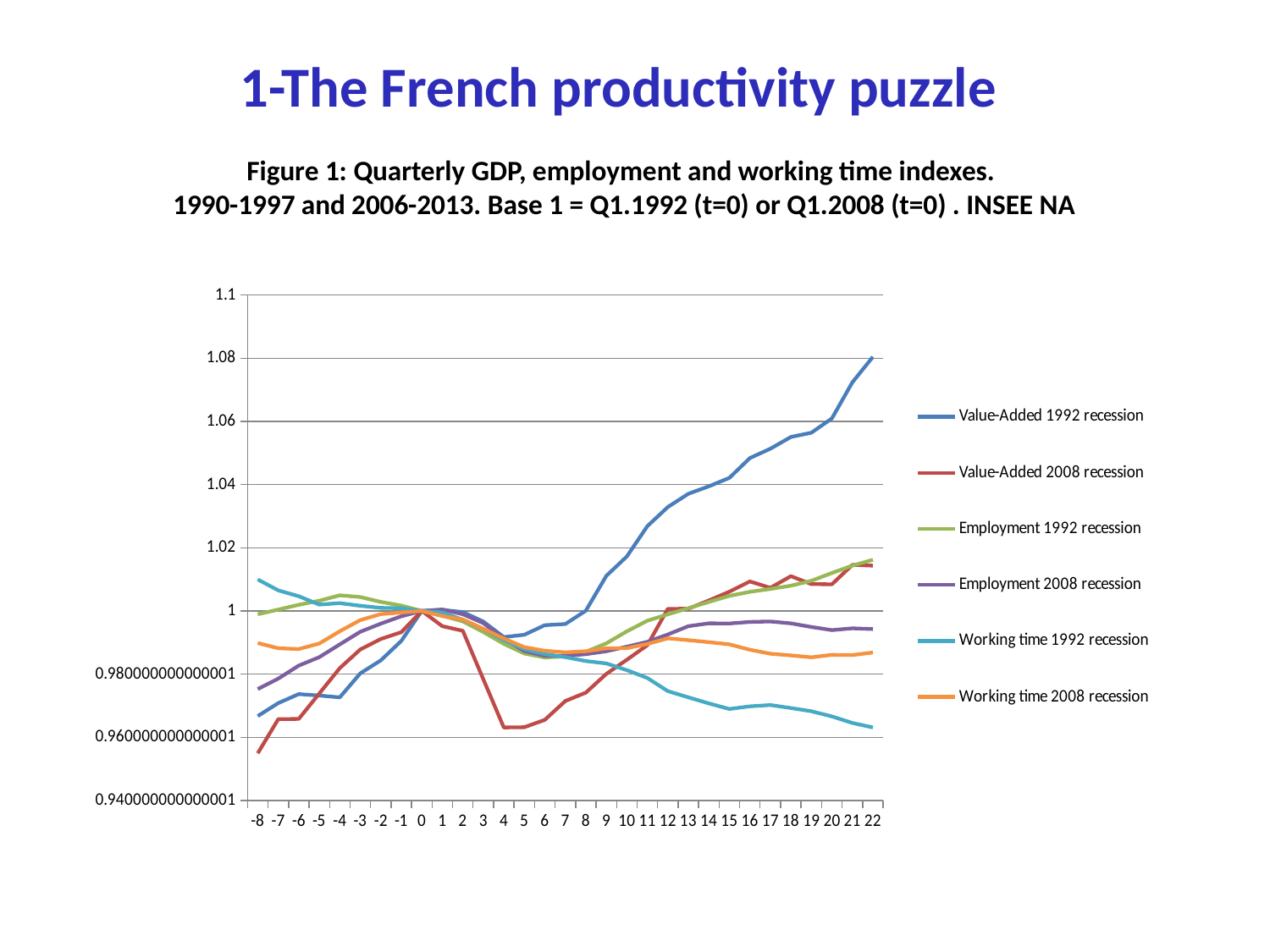
What is the value of the Value-Added 1992 recession series at t=0? 1 How many series does the legend list? 6 Is the value for Value-Added 1992 recession at t=22 greater or less than 1.06? greater Is the value for Value-Added 2008 recession at t=4 greater or less than 0.98? less Does the Value-Added 1992 recession series rise or fall from t=0 to t=22? rise What colour is the line for Value-Added 2008 recession in the legend? red Which series has the highest value at t=22? Value-Added 1992 recession Is the value for Working time 1992 recession at t=22 greater or less than 0.98? less Which series has the lowest value at t=22? Working time 1992 recession What kind of chart is shown on the slide? line chart How many quarters (x-axis points) are plotted, from -8 to 22? 31 At t=22, which is larger: Value-Added 1992 recession or Working time 1992 recession? Value-Added 1992 recession